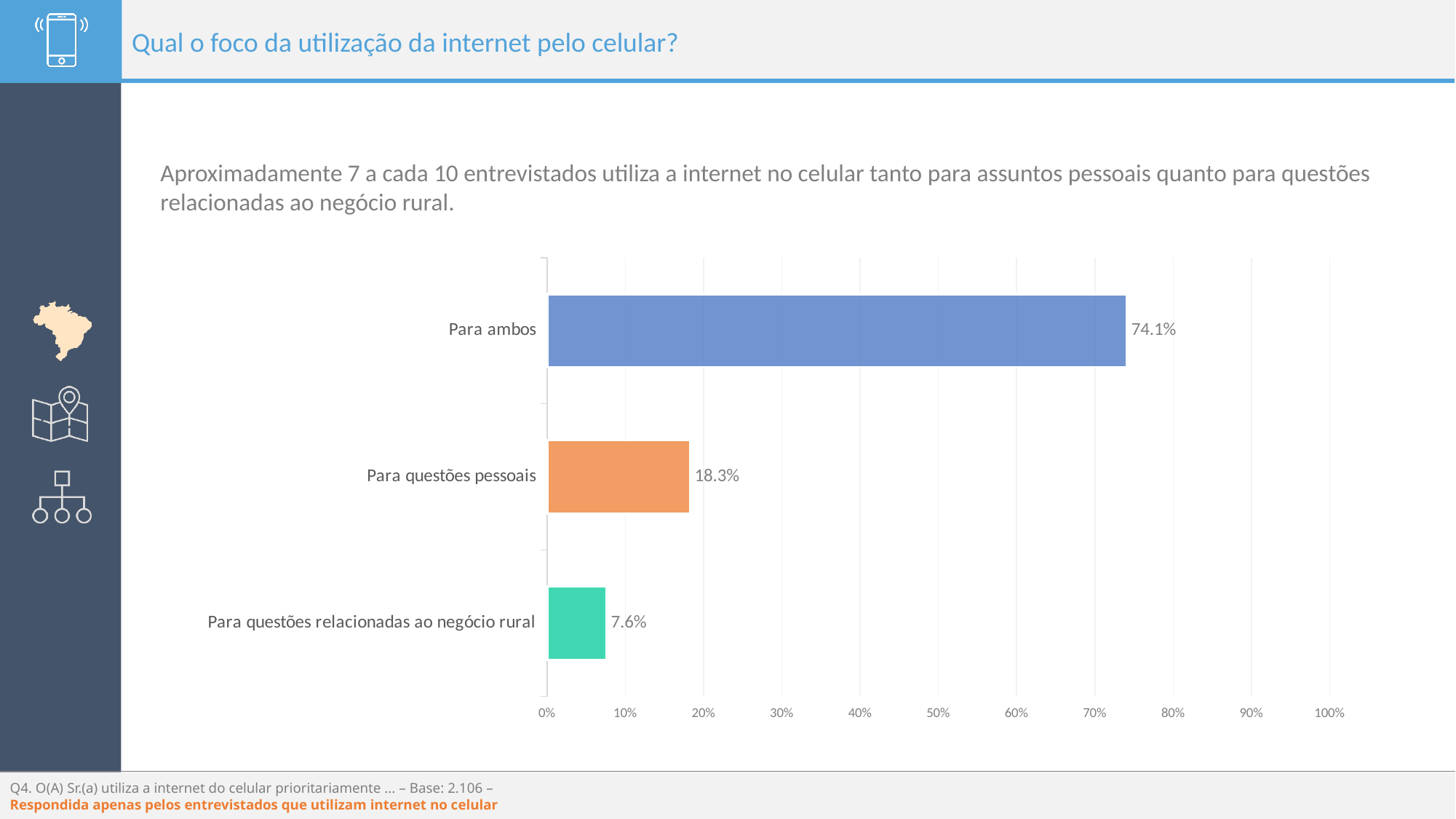
Which category has the lowest value? Para questões relacionadas ao negócio rural What colour is the bar for "Para questões pessoais"? Orange What is the value for "Para ambos"? 74.1% What is the difference between the values for "Para questões pessoais" and "Para questões relacionadas ao negócio rural"? 10.7% Is the value for "Para ambos" greater or less than 70%? greater Which category has the highest value? Para ambos What is the value for "Para questões pessoais"? 18.3% Which is larger, the value for "Para questões pessoais" or the value for "Para questões relacionadas ao negócio rural"? Para questões pessoais How many categories are shown in the chart? 3 What is the difference between the values for "Para ambos" and "Para questões pessoais"? 55.8% What is the value for "Para questões relacionadas ao negócio rural"? 7.6% What kind of chart is shown on the slide? Bar chart